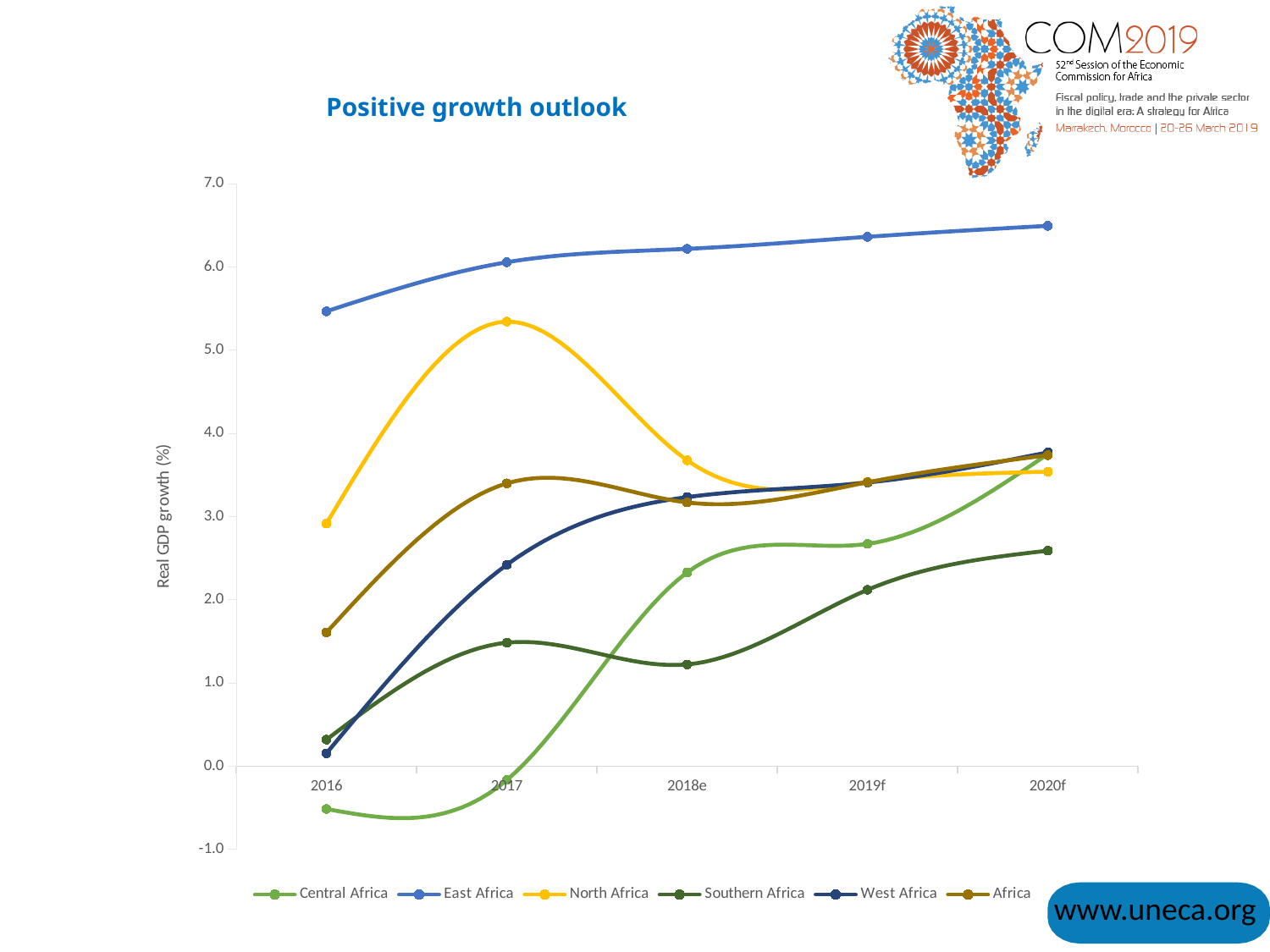
How many time points are shown along the x axis? 5 In 2018e, which is larger: North Africa or Southern Africa? North Africa Does the East Africa line rise or fall from 2016 to 2020f? rises Is the value for East Africa in 2020f greater or less than 6.0? greater What kind of chart is shown on the slide? line chart Which region has the lowest real GDP growth in 2016? Central Africa How many series does the legend list? 6 What is the label on the y axis of the chart? Real GDP growth (%) Is the value for North Africa in 2017 greater or less than 5.0? greater Which region has the lowest real GDP growth in 2020f? Southern Africa Which region has the highest real GDP growth in 2016? East Africa Is the value for Central Africa in 2016 greater or less than 0.0? less